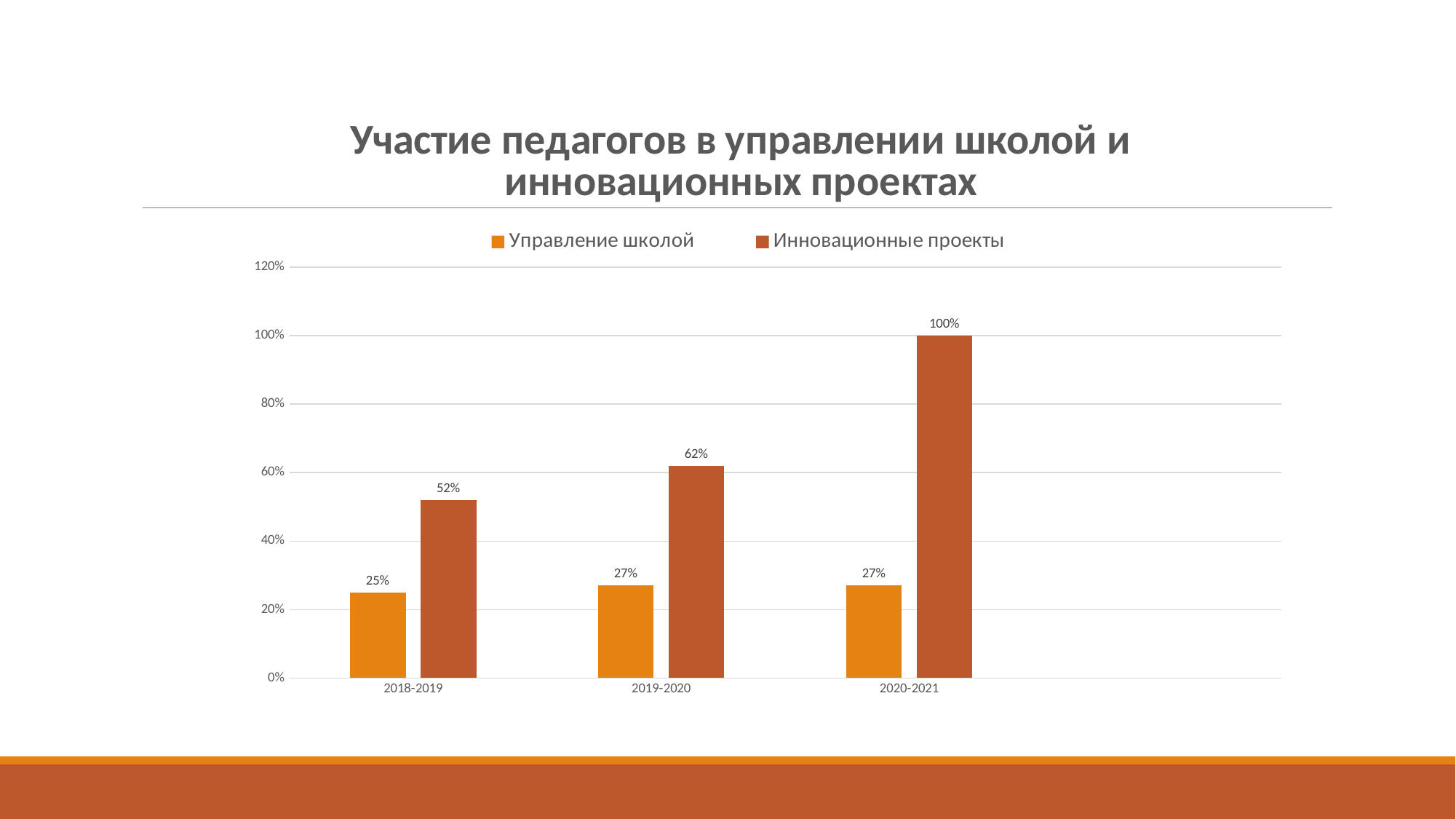
What is the value for Управление школой in 2018-2019? 25% In which year is the value for Инновационные проекты highest? 2020-2021 In which year is the value for Управление школой lowest? 2018-2019 Which is larger in 2018-2019: Управление школой or Инновационные проекты? Инновационные проекты How many series does the legend list? 2 What kind of chart is shown on the slide? Bar chart How many year categories are shown on the x axis? 3 What is the value for Инновационные проекты in 2019-2020? 62% What is the difference between the Инновационные проекты values for 2019-2020 and 2018-2019? 10% What is the value for Инновационные проекты in 2020-2021? 100% Do the values for Инновационные проекты rise or fall from 2018-2019 to 2020-2021? Rise What is the difference between Инновационные проекты and Управление школой in 2020-2021? 73%